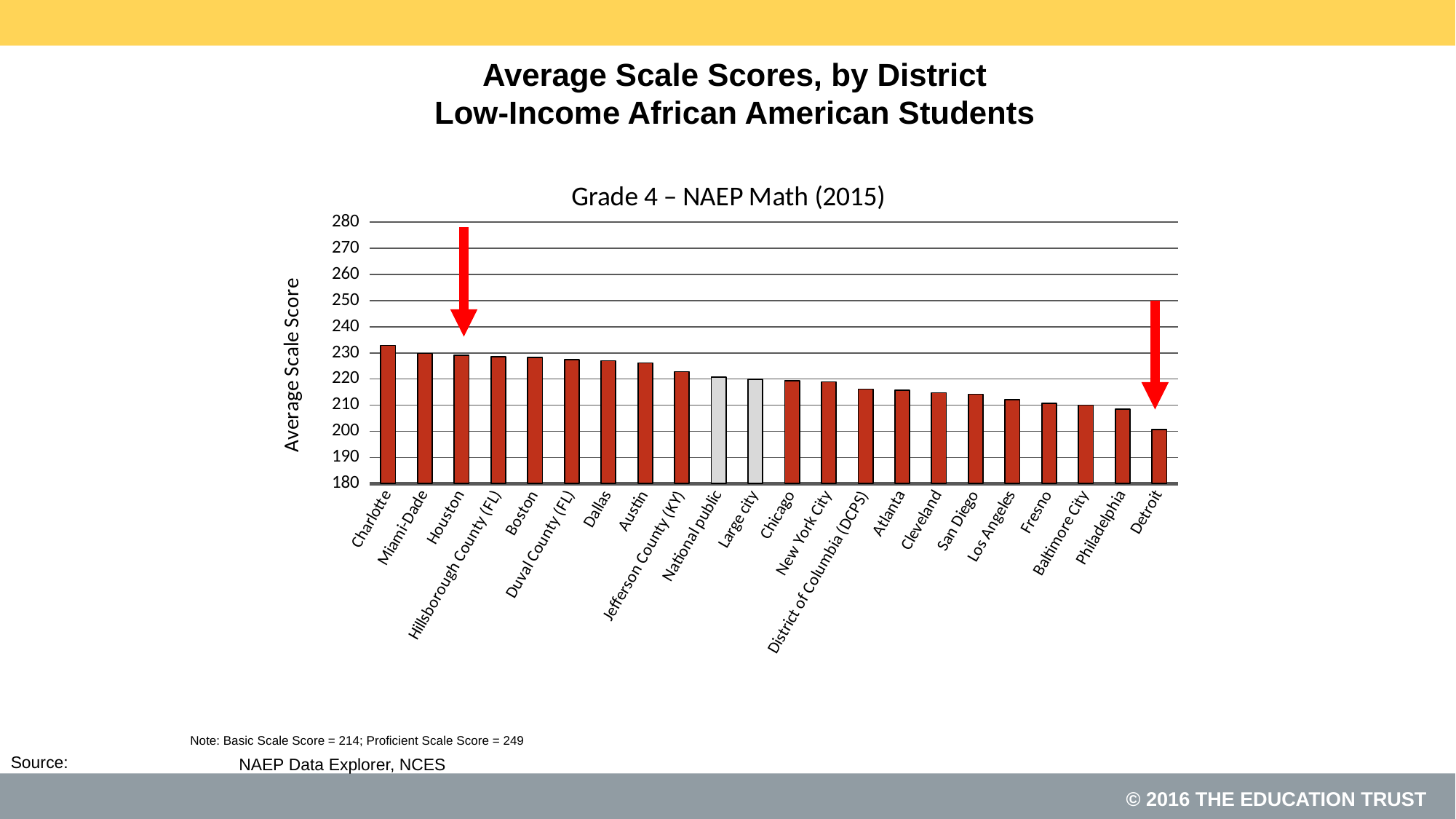
Which two bars are shaded grey instead of red? National public and Large city Which district has the lowest average scale score? Detroit Which has a higher average scale score, Boston or Atlanta? Boston Is the value for Atlanta greater or less than 220? less What kind of chart is shown on the slide? Bar chart Is the value for Charlotte greater or less than 230? greater Which district has the highest average scale score? Charlotte Is the value for Austin greater or less than 220? greater Do the values rise or fall moving from left to right along the x axis? Fall What is the title shown above the chart's plot area? Grade 4 – NAEP Math (2015) How many districts or groups are plotted along the x axis? 22